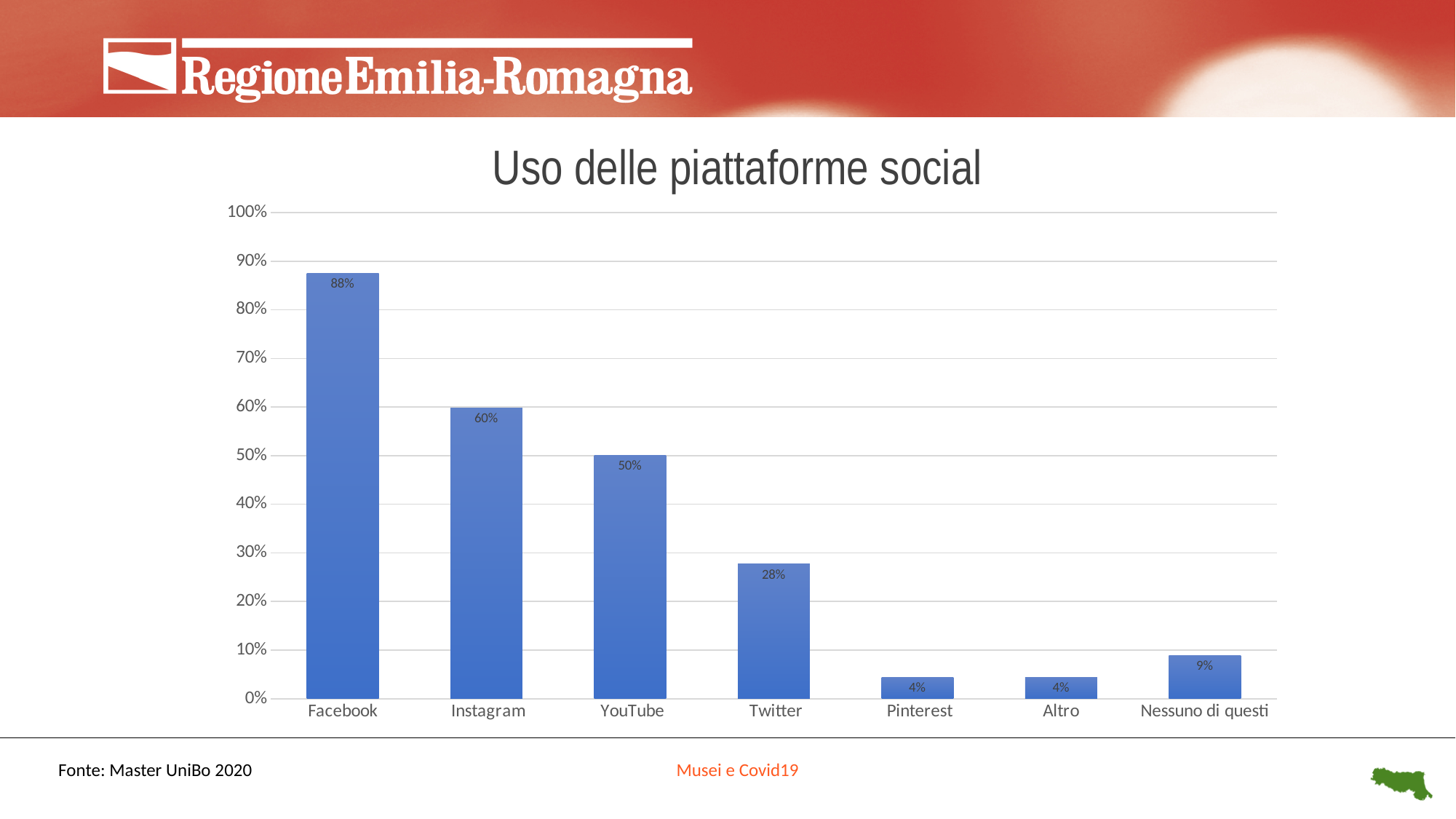
What is the value for Instagram? 60% What is the difference between the values for Facebook and Instagram? 28% Is the value for Twitter greater or less than 30%? less Which is larger, the value for YouTube or the value for Nessuno di questi? YouTube What is the difference between the values for YouTube and Twitter? 22% What kind of chart is shown on the slide? bar chart What is the value for Facebook? 88% How many categories are shown on the x axis? 7 What is the value for Twitter? 28% What is the title of the chart? Uso delle piattaforme social Which category has the highest value? Facebook What is the value for Nessuno di questi? 9%